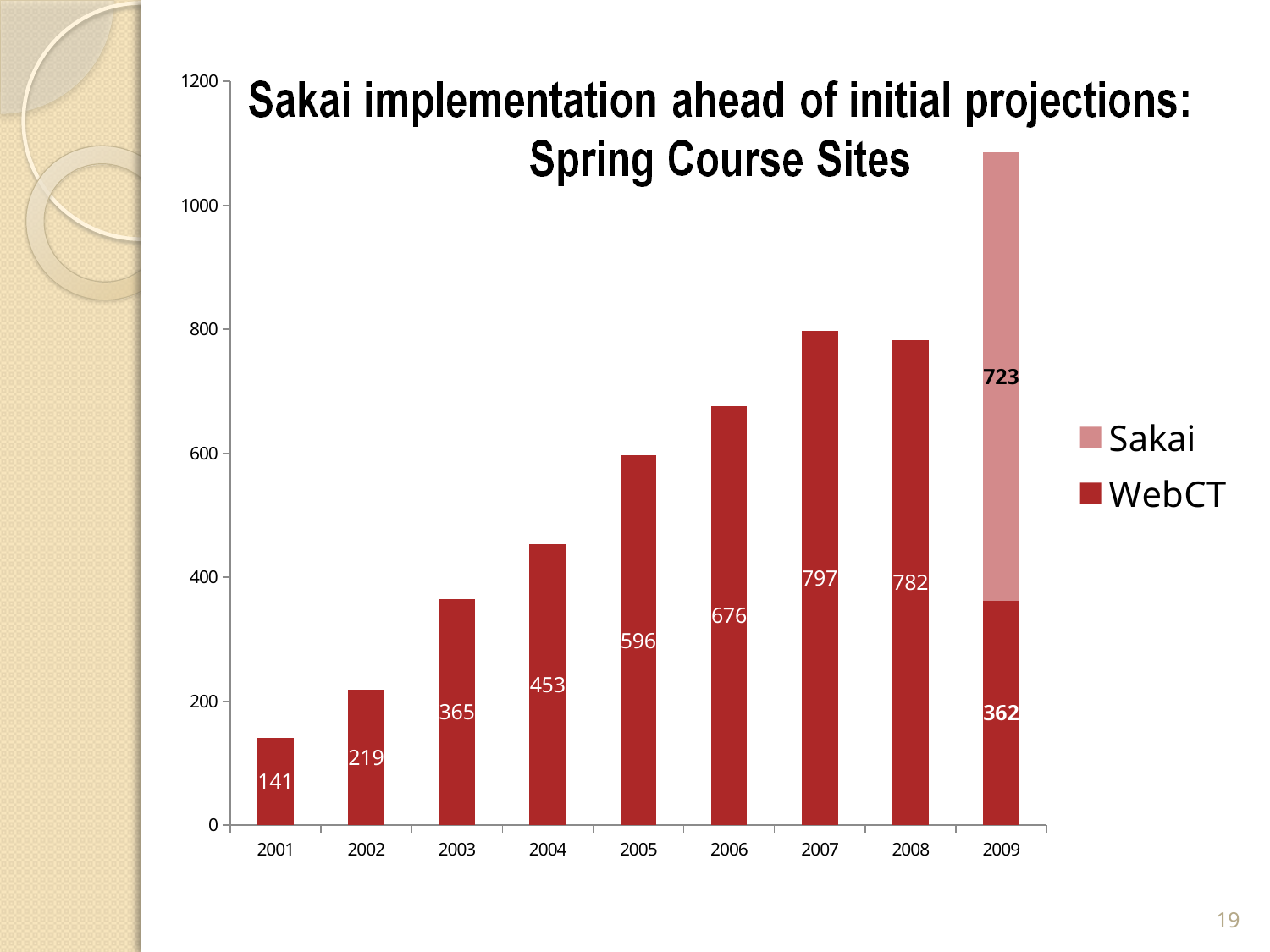
What is the WebCT value for 2001? 141 What is the Sakai value for 2009? 723 Do the WebCT values generally rise or fall from 2001 to 2007? Rise Which is larger, the WebCT value for 2004 or for 2006? 2006 What kind of chart is shown on the slide? Stacked bar chart Which year has the highest WebCT value? 2007 How many years are shown on the x axis? 9 What is the WebCT value for 2005? 596 What is the total of the stacked bar for 2009? 1085 How many series does the legend list? 2 Which year has the lowest WebCT value? 2001 What is the difference between the WebCT values for 2007 and 2008? 15